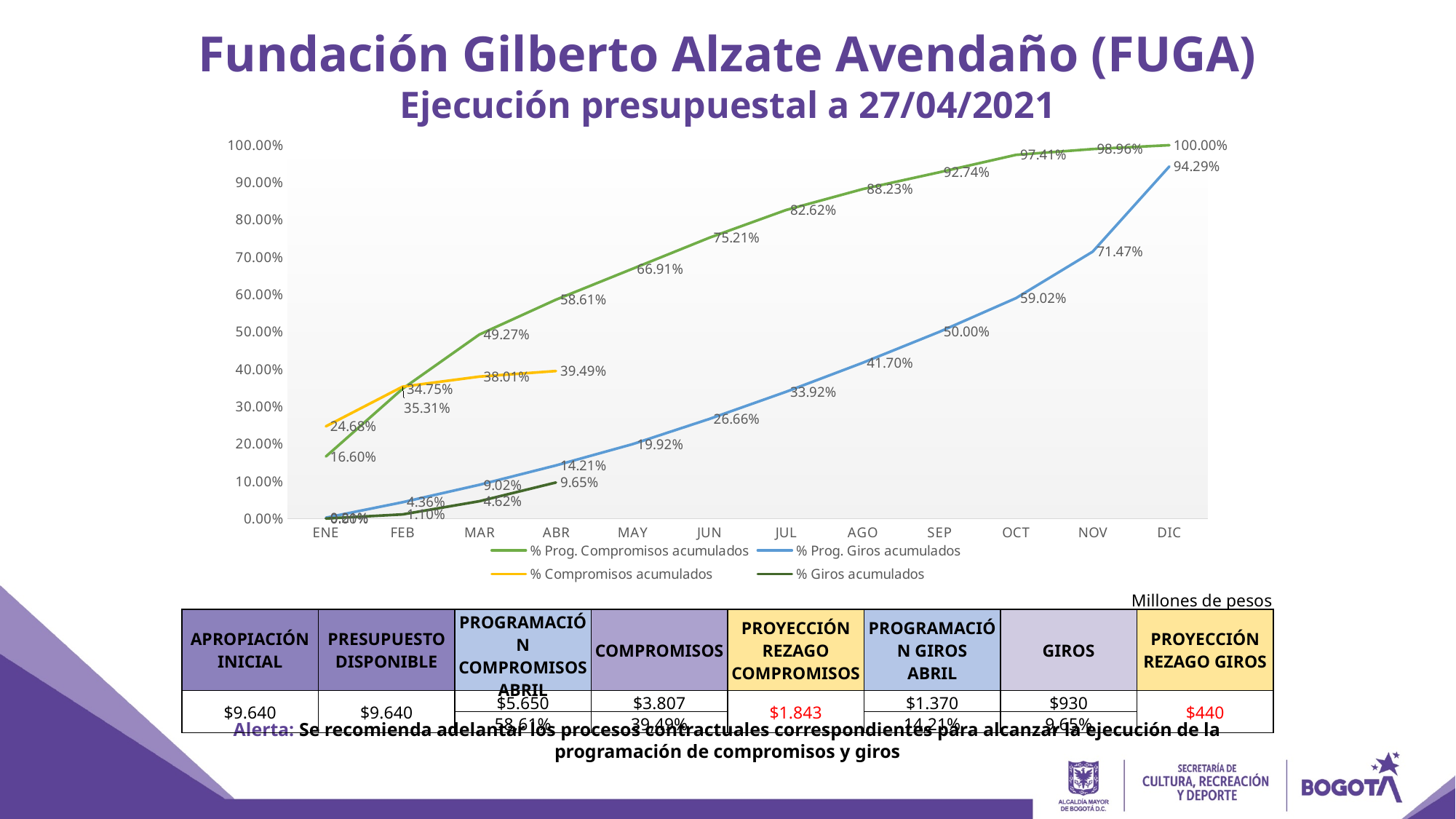
What is the value of % Prog. Giros acumulados in DIC? 94.29% What is the value of % Prog. Giros acumulados in SEP? 50.00% What colour is the % Prog. Giros acumulados line in the chart? Blue How many series does the chart legend list? 4 What kind of chart is shown on the slide? Line chart What is the value of % Compromisos acumulados in ABR? 39.49% What is the value of % Prog. Compromisos acumulados in DIC? 100.00% Does the % Prog. Giros acumulados line rise or fall from ENE to DIC? Rises What is the difference between % Prog. Compromisos acumulados and % Compromisos acumulados in ABR? 19.12 percentage points How many months are shown along the x axis of the chart? 12 What is the value of % Giros acumulados in ABR? 9.65% In MAR, which is larger: % Prog. Compromisos acumulados or % Compromisos acumulados? % Prog. Compromisos acumulados